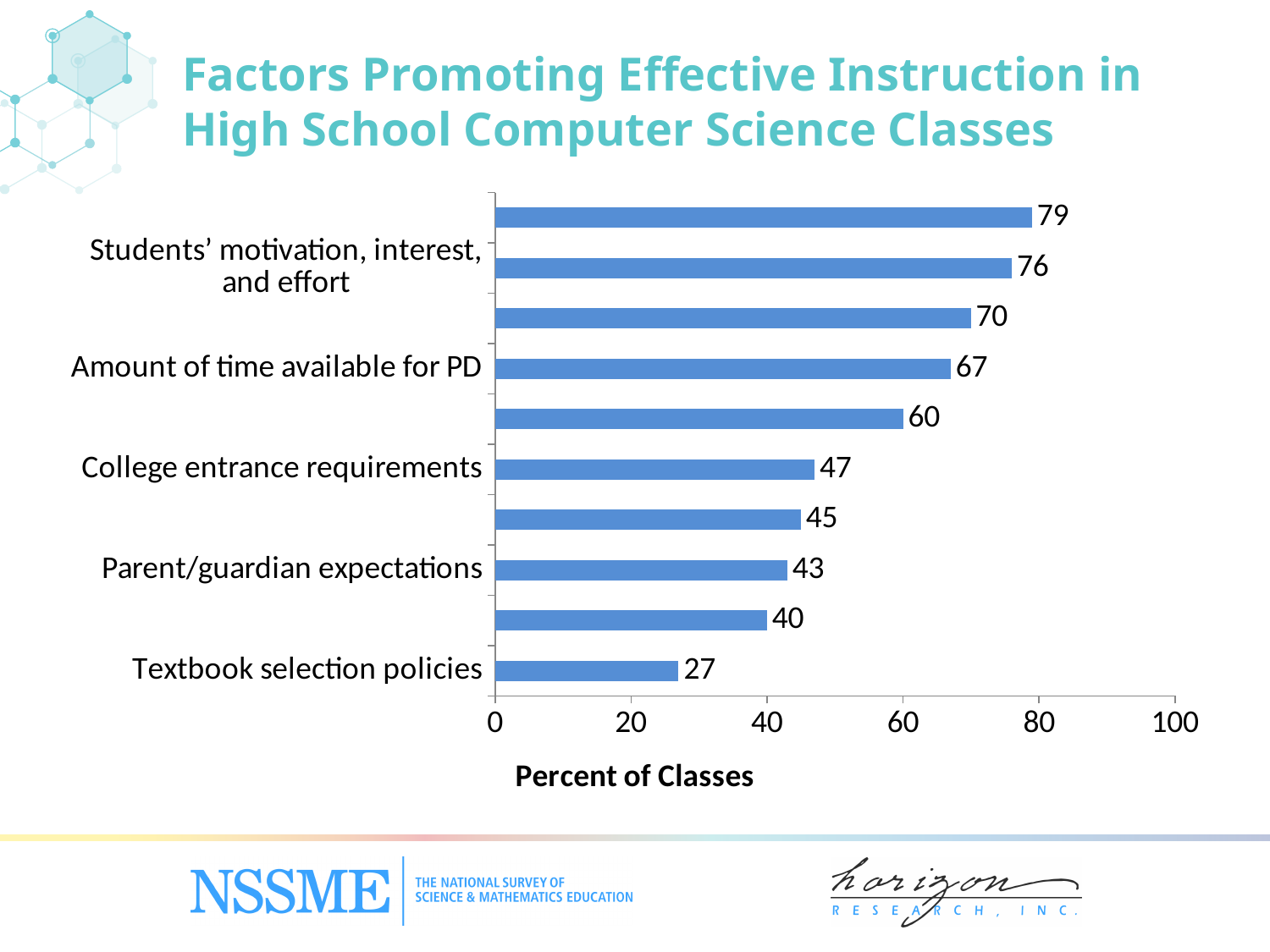
What is the difference between the values for Amount of time available for PD and College entrance requirements? 20 What is the value for Parent/guardian expectations? 43 What is the value for Amount of time available for PD? 67 What is the value for Students' motivation, interest, and effort? 76 Which is larger, the value for College entrance requirements or the value for Parent/guardian expectations? College entrance requirements What is the value for College entrance requirements? 47 What is the difference between the values for Students' motivation, interest, and effort and Textbook selection policies? 49 What is the label of the horizontal axis? Percent of Classes What is the value for Textbook selection policies? 27 How many bars are plotted in the chart? 10 What kind of chart is shown on the slide? Bar chart Which labeled category has the lowest value? Textbook selection policies